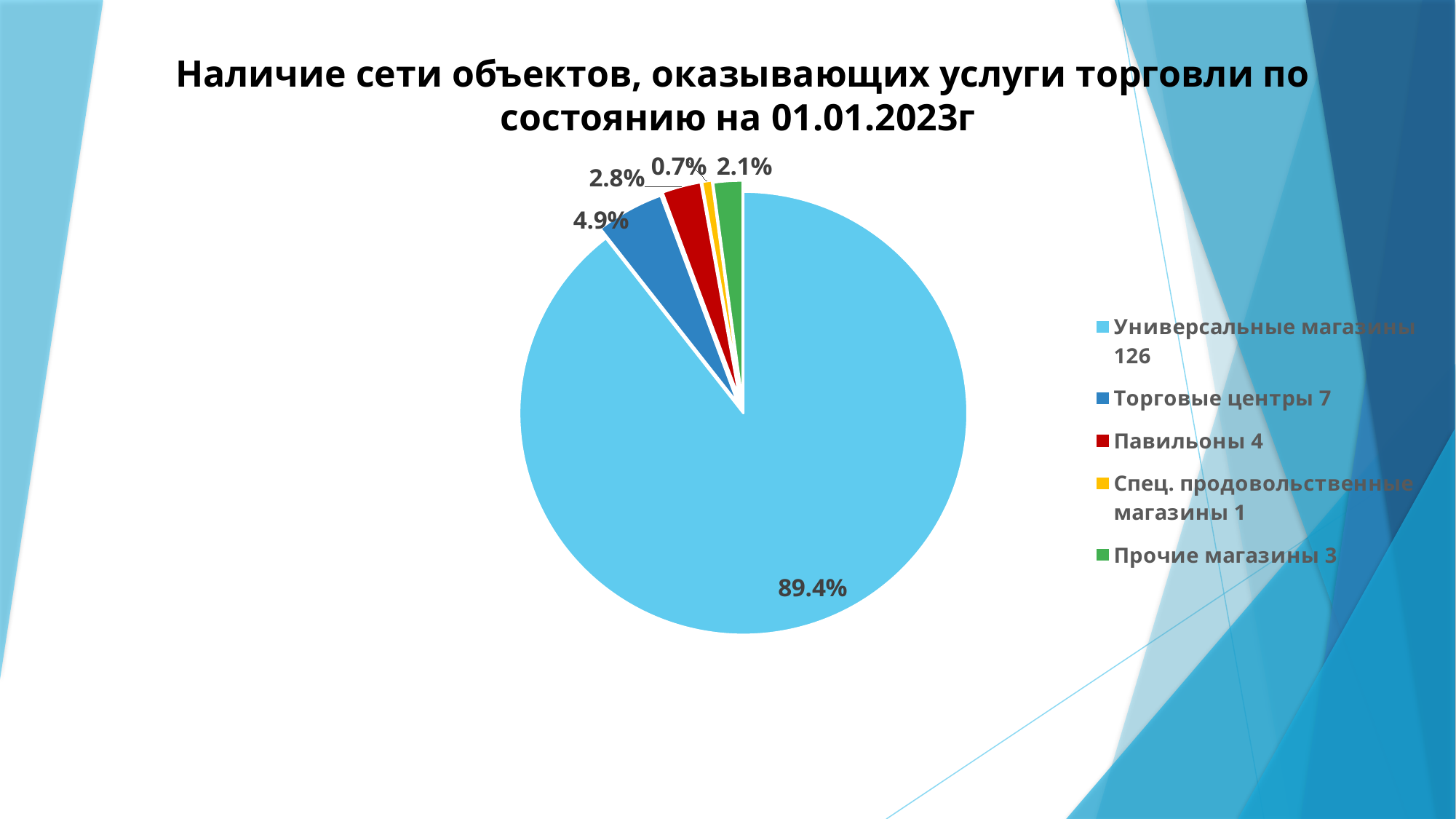
Which category has the smallest slice of the pie? Спец. продовольственные магазины What colour is the slice for Павильоны? red What percentage share does the slice for Павильоны have? 2.8% What percentage share does the slice for Спец. продовольственные магазины have? 0.7% Which category has the largest slice of the pie? Универсальные магазины How many categories does the pie chart show? 5 What percentage share does the slice for Прочие магазины have? 2.1% What kind of chart is shown on the slide? pie chart What is the difference in percentage points between the Торговые центры slice and the Павильоны slice? 2.1% Which slice is larger: Торговые центры or Прочие магазины? Торговые центры